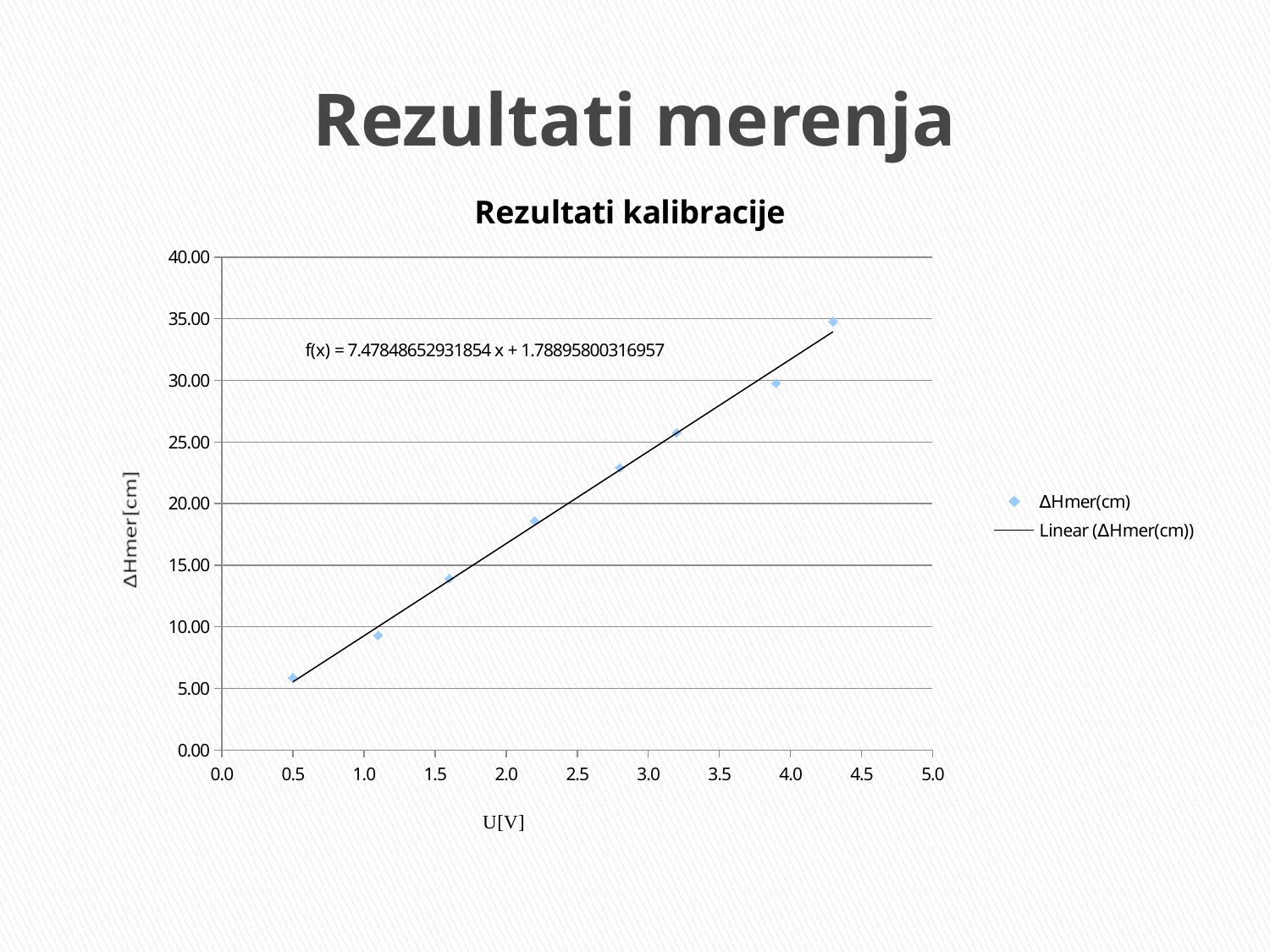
Is the ΔHmer(cm) value at U = 2.2 V greater or less than 20.00? less What is the title of the chart? Rezultati kalibracije What is the label of the horizontal axis? U[V] At which U[V] value is the ΔHmer(cm) point lowest? 0.5 How many data points are plotted in the ΔHmer(cm) series? 8 Is the ΔHmer(cm) value at U = 2.8 V greater or less than 20.00? greater Is the ΔHmer(cm) value at U = 4.3 V greater or less than 30.00? greater How many series does the chart legend list? 2 What kind of chart is shown on the slide? Scatter chart At which U[V] value is the ΔHmer(cm) point highest? 4.3 Do the ΔHmer(cm) values rise or fall as U[V] increases? Rise